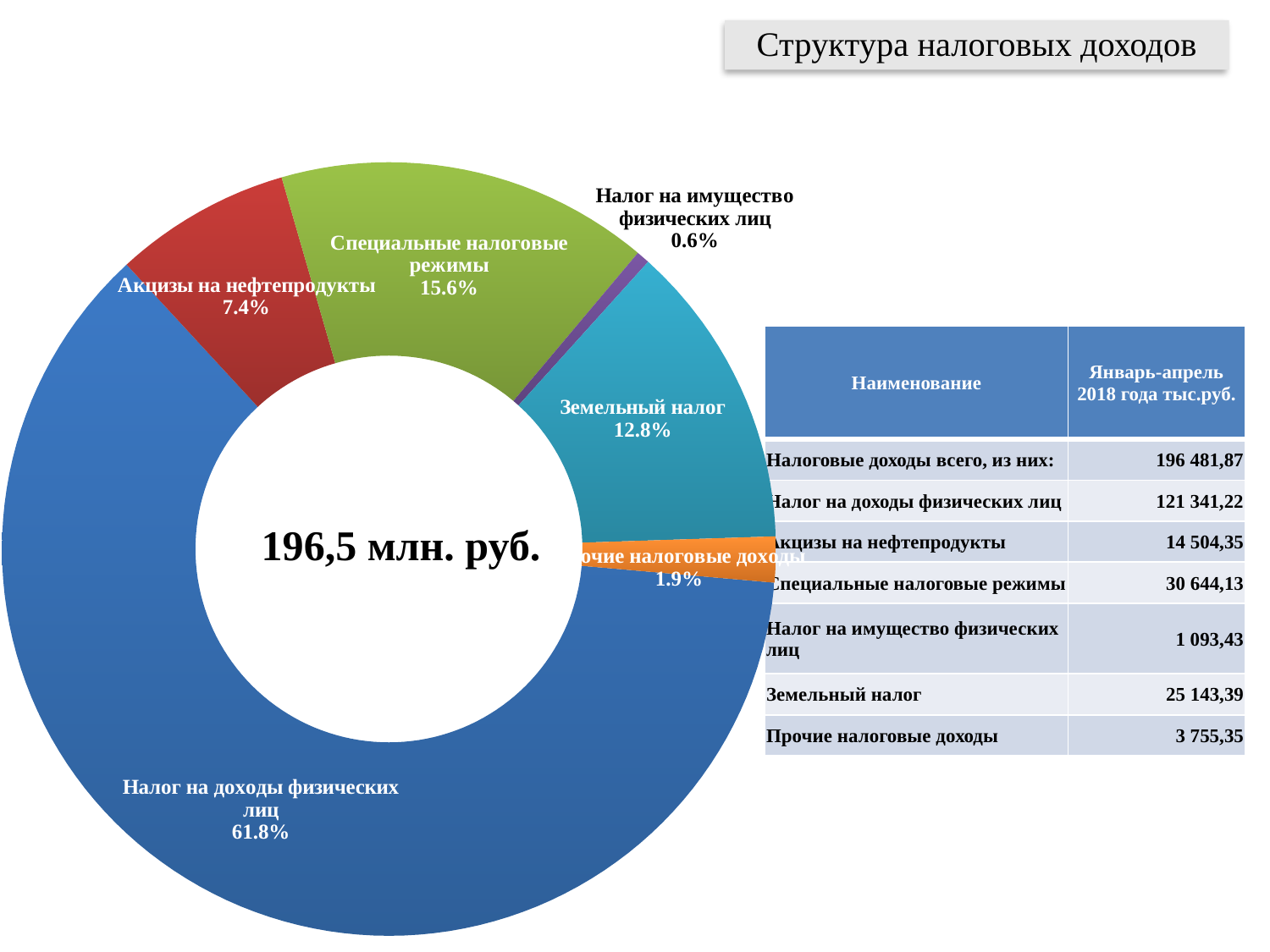
How many categories are shown in the chart? 6 What total value is printed in the centre of the chart? 196,5 млн. руб. What percentage is shown for Акцизы на нефтепродукты in the chart? 7.4% What is the difference in percentage points between Специальные налоговые режимы and Земельный налог? 2.8 What percentage is shown for Специальные налоговые режимы in the chart? 15.6% What percentage is shown for Налог на имущество физических лиц in the chart? 0.6% What share of the pie chart does Налог на доходы физических лиц represent? 61.8% What percentage is shown for Земельный налог in the chart? 12.8% Which category has the smallest share in the chart? Налог на имущество физических лиц Which has a larger share: Акцизы на нефтепродукты or Прочие налоговые доходы? Акцизы на нефтепродукты What kind of chart is shown on the slide? Doughnut (pie) chart Which category has the largest share in the chart? Налог на доходы физических лиц